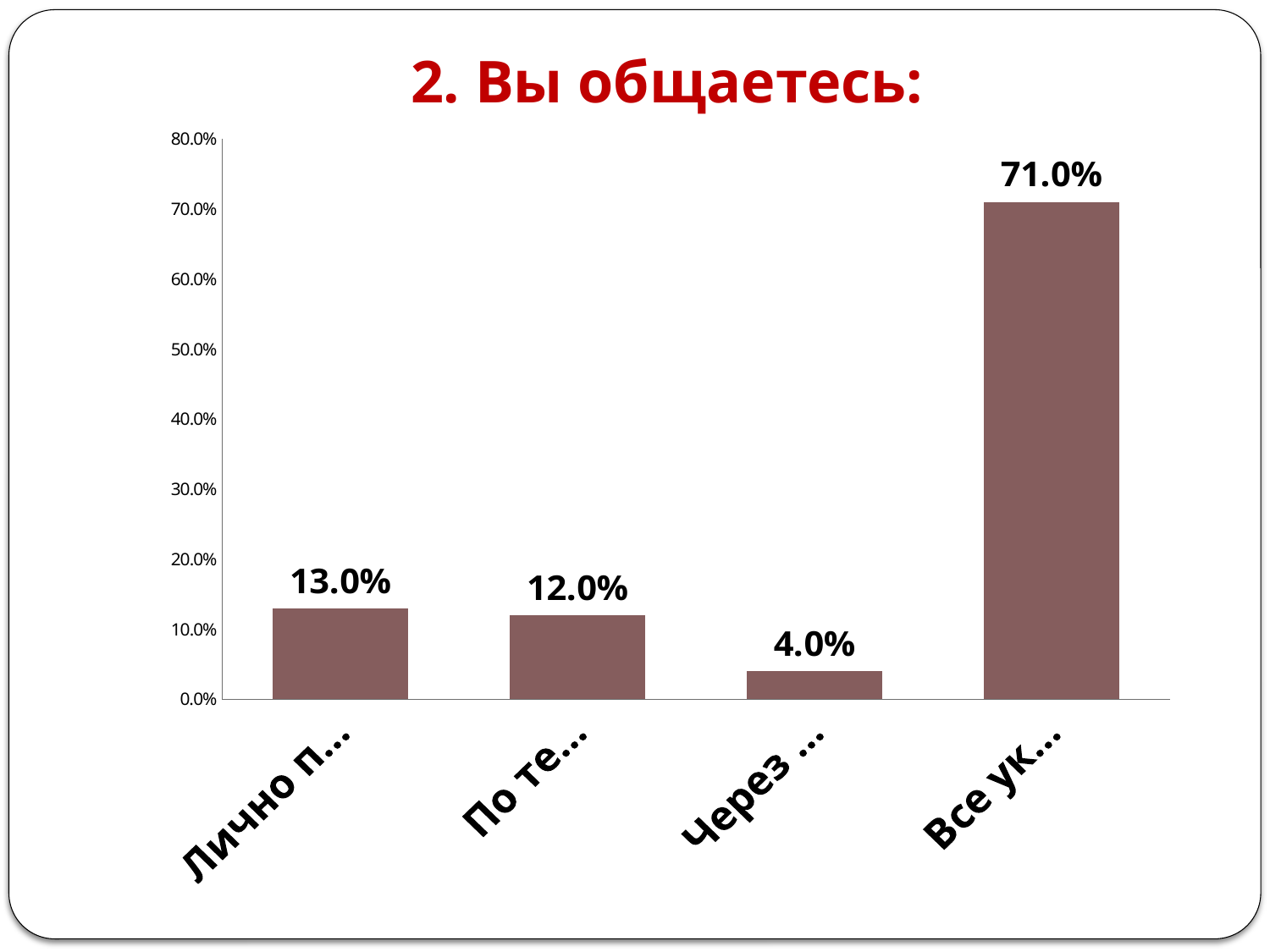
What is the title of the slide above the chart? 2. Вы общаетесь: Which bar has the highest value? The fourth (rightmost) bar, "Все ук..." What is the value of the third bar, labelled "Через ..."? 4.0% What is the value of the fourth (rightmost) bar, labelled "Все ук..."? 71.0% How many bars (categories) are shown in the chart? 4 Which bar has the lowest value? The third bar, "Через ..." What kind of chart is shown on the slide? Bar chart What is the value of the second bar, labelled "По те..."? 12.0% What is the value of the first (leftmost) bar, labelled "Лично п..."? 13.0% What is the difference between the value of the rightmost bar (71.0%) and the leftmost bar (13.0%)? 58.0% Which is larger: the value of the first bar or the value of the second bar? The first bar (13.0%) What is the difference between the first bar (13.0%) and the third bar (4.0%)? 9.0%